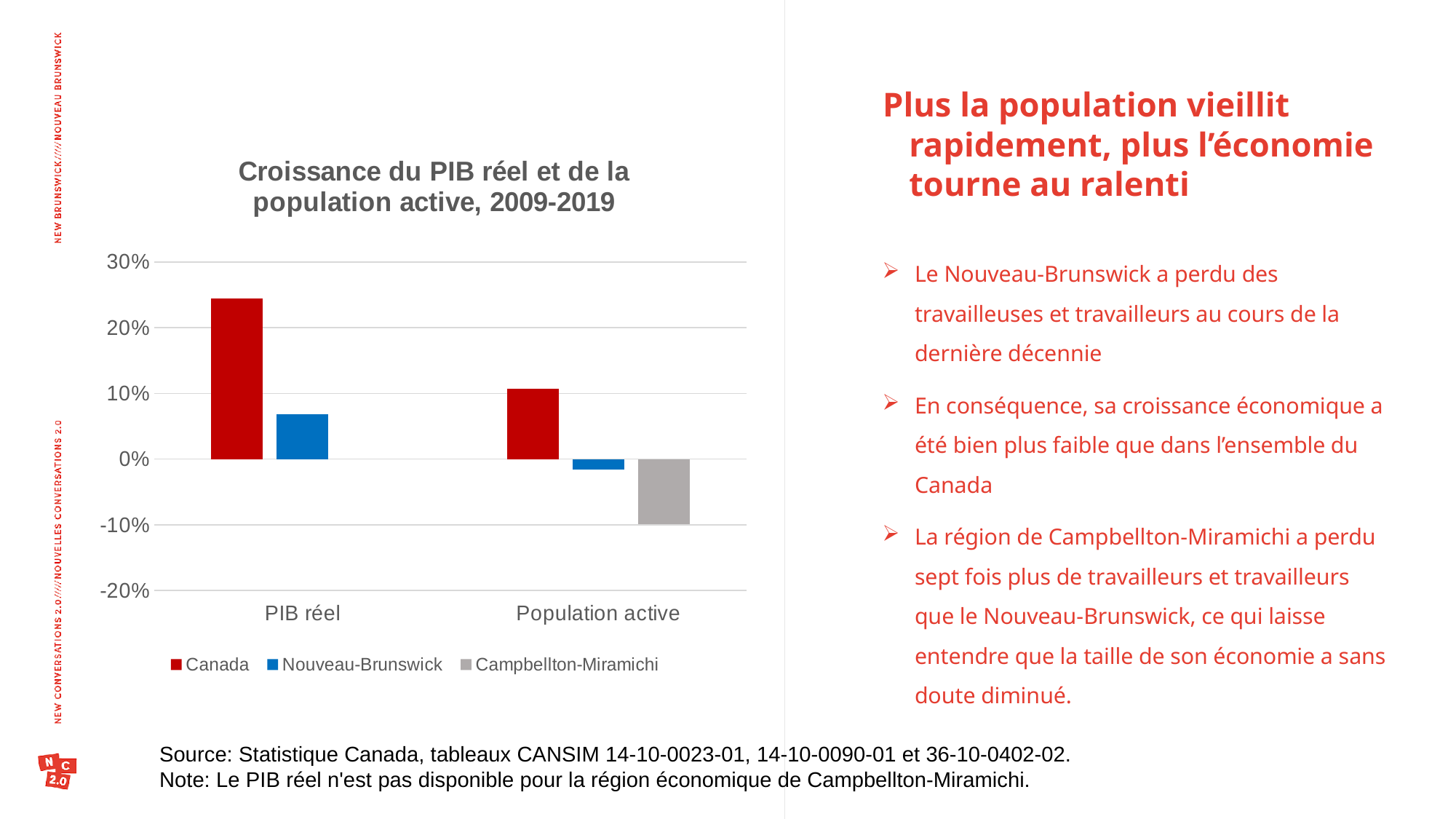
How many series does the chart legend list? 3 Is the value for Nouveau-Brunswick in PIB réel greater or less than 10%? less Is the value for Canada in PIB réel greater or less than 20%? greater What kind of chart is shown on the slide? bar chart Which series has the lowest value for Population active? Campbellton-Miramichi For Canada, which category has the larger value: PIB réel or Population active? PIB réel For PIB réel, which is larger: the value for Canada or the value for Nouveau-Brunswick? Canada How many categories are shown on the x axis of the chart? 2 Which series has the highest value for PIB réel? Canada Is the value for Nouveau-Brunswick in Population active greater or less than 0%? less Which series is shown in red in the chart? Canada What is the title of the chart? Croissance du PIB réel et de la population active, 2009-2019